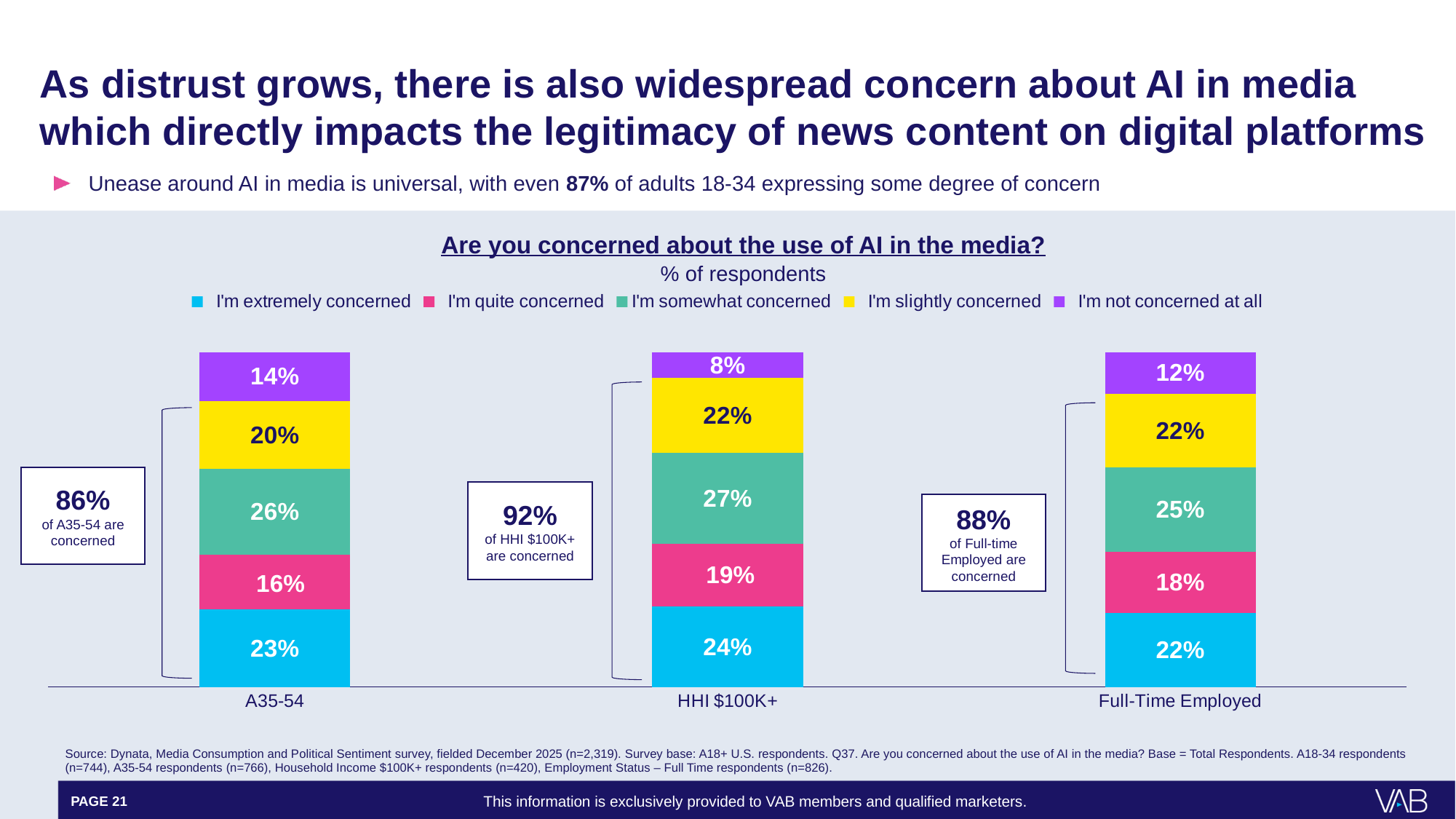
What is the difference in the "I'm quite concerned" share between Full-Time Employed and A35-54? 2 percentage points What percentage of HHI $100K+ respondents said "I'm extremely concerned"? 24% How many categories are shown on the x axis of the chart? 3 Which category has the lowest share of "I'm not concerned at all" respondents? HHI $100K+ What is the total of the stacked bar for HHI $100K+? 100% What percentage of Full-Time Employed respondents said "I'm somewhat concerned"? 25% Which category has the highest share of "I'm somewhat concerned" respondents? HHI $100K+ What percentage of HHI $100K+ respondents said "I'm slightly concerned"? 22% Which has a larger "I'm extremely concerned" share, A35-54 or Full-Time Employed? A35-54 What percentage of A35-54 respondents said "I'm not concerned at all"? 14% What kind of chart is shown on the slide? Stacked bar chart How many series does the legend list? 5